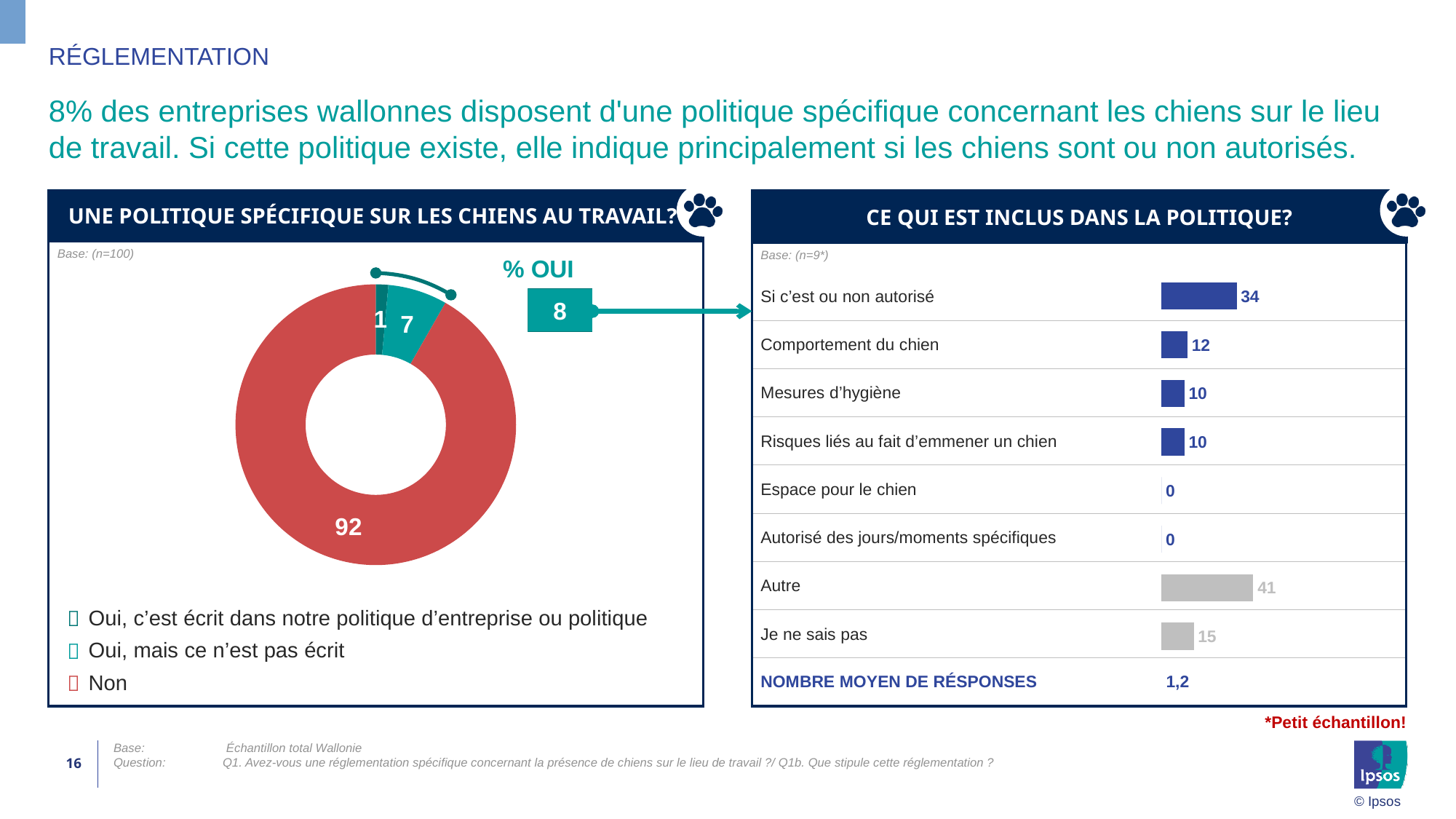
How many categories are shown in the chart 'CE QUI EST INCLUS DANS LA POLITIQUE?'? 8 In the chart 'CE QUI EST INCLUS DANS LA POLITIQUE?', what is the value for 'Si c'est ou non autorisé'? 34 In the chart 'UNE POLITIQUE SPÉCIFIQUE SUR LES CHIENS AU TRAVAIL?', what is the value for 'Oui, c'est écrit dans notre politique d'entreprise ou politique'? 1 In the chart 'CE QUI EST INCLUS DANS LA POLITIQUE?', what is the value for 'Comportement du chien'? 12 In the chart 'UNE POLITIQUE SPÉCIFIQUE SUR LES CHIENS AU TRAVAIL?', what is the value for 'Non'? 92 In the chart 'CE QUI EST INCLUS DANS LA POLITIQUE?', which is larger: 'Mesures d'hygiène' or 'Je ne sais pas'? Je ne sais pas What kind of chart is 'UNE POLITIQUE SPÉCIFIQUE SUR LES CHIENS AU TRAVAIL?'? Doughnut chart What kind of chart is 'CE QUI EST INCLUS DANS LA POLITIQUE?'? Bar chart In the chart 'UNE POLITIQUE SPÉCIFIQUE SUR LES CHIENS AU TRAVAIL?', what is the '% OUI' value shown in the callout? 8 In the chart 'CE QUI EST INCLUS DANS LA POLITIQUE?', which category has the highest value? Autre In the chart 'CE QUI EST INCLUS DANS LA POLITIQUE?', what is the difference between 'Si c'est ou non autorisé' and 'Comportement du chien'? 22 In the chart 'UNE POLITIQUE SPÉCIFIQUE SUR LES CHIENS AU TRAVAIL?', what is the value for 'Oui, mais ce n'est pas écrit'? 7